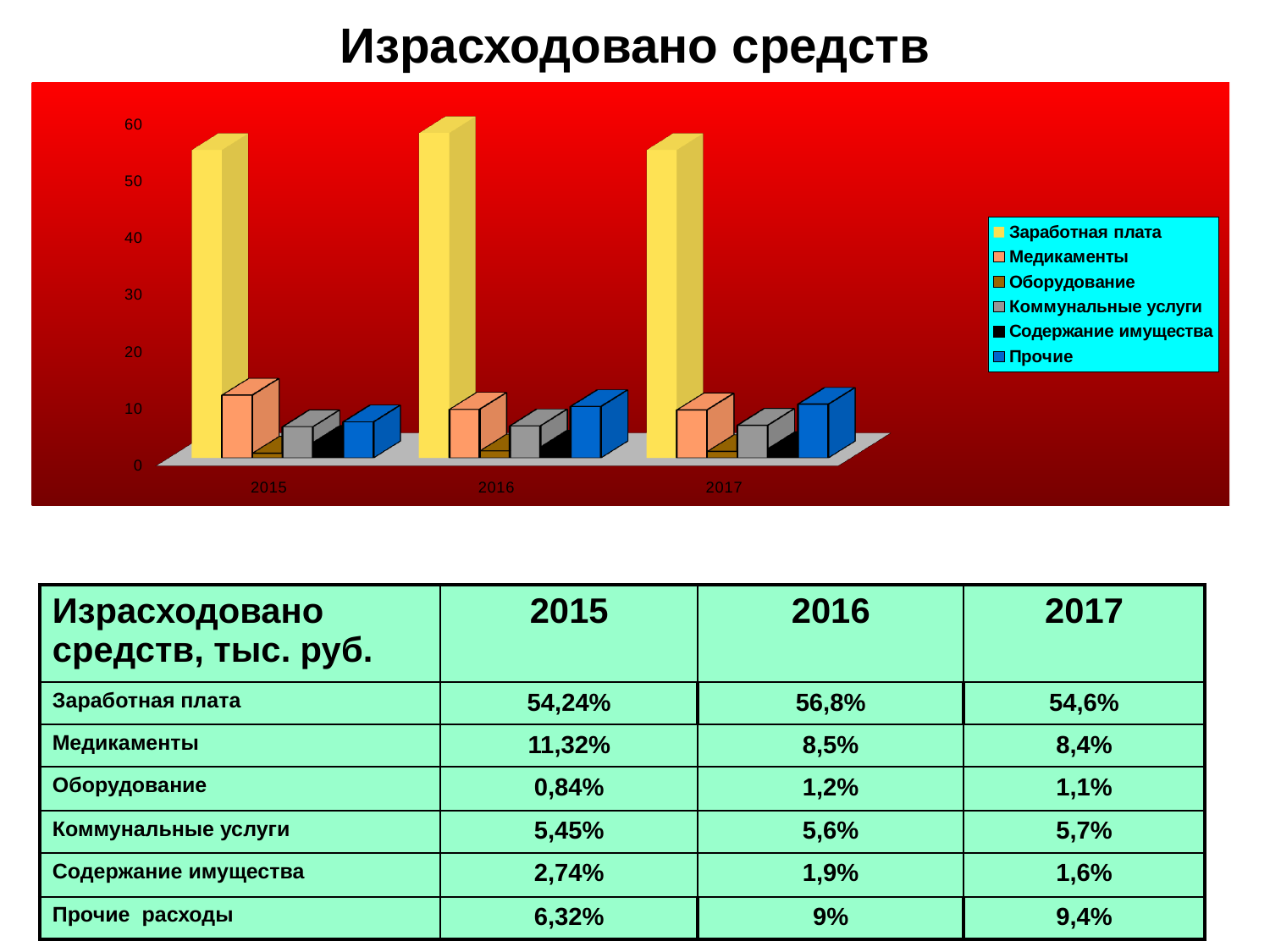
How many series does the chart legend list? 6 Which series has the tallest bar in every year of the chart? Заработная плата What kind of chart is shown on the slide? bar chart Does the value for Прочие rise or fall from 2015 to 2017? rise Is the value for Заработная плата in 2016 greater or less than 50? greater Which is larger, the Медикаменты value for 2015 or for 2016? 2015 Is the value for Медикаменты in 2015 greater or less than 20? less According to the table, what is the value for Заработная плата in 2016? 56,8% Which series has the shortest bar in 2015? Оборудование What colour represents Заработная плата in the chart legend? yellow According to the table, what is the value for Прочие расходы in 2017? 9,4% How many year categories are shown on the x axis of the chart? 3